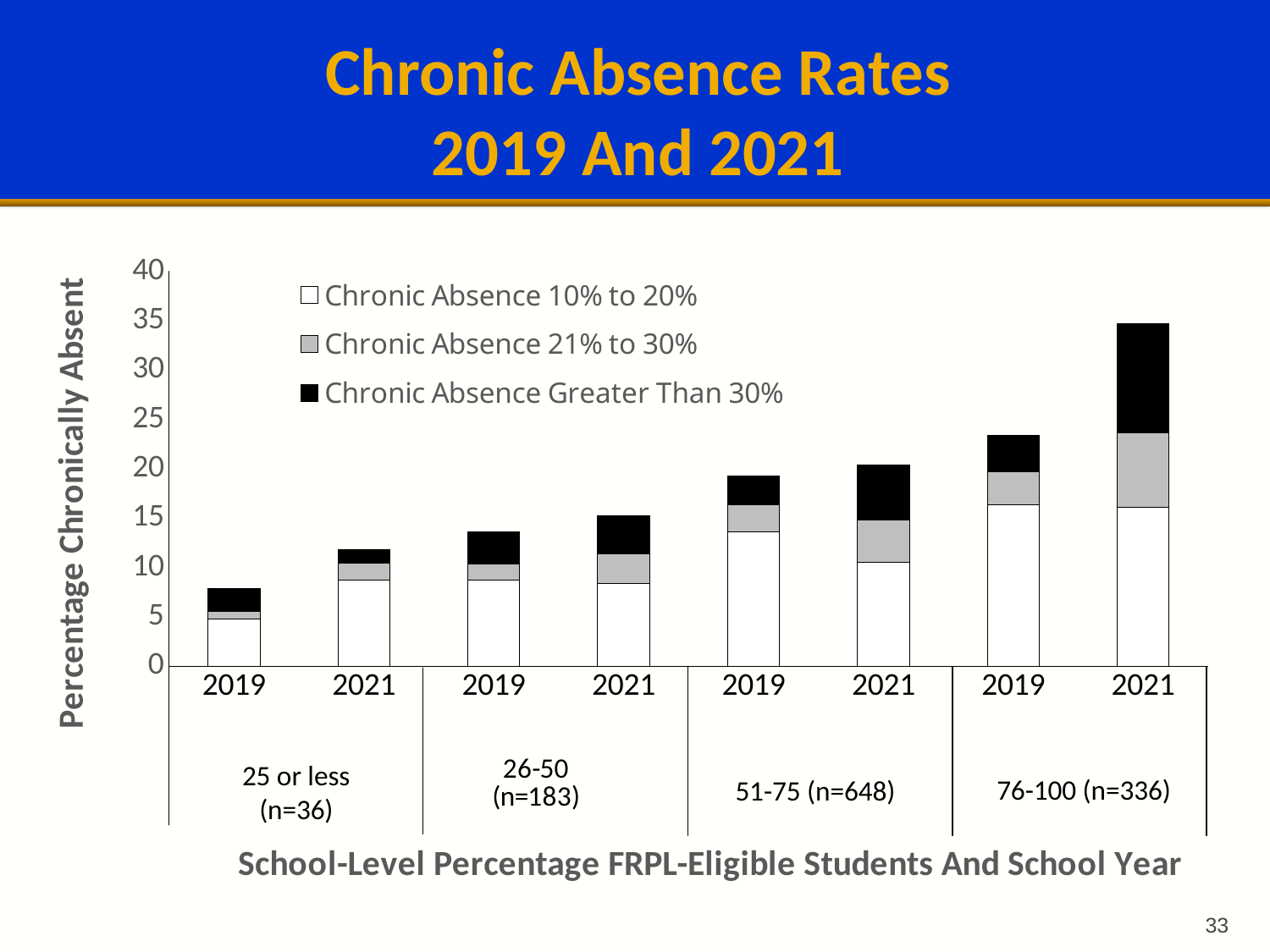
Is the total percentage chronically absent for the 25 or less group in 2019 greater or less than 10? less What kind of chart is shown on the slide? Stacked bar chart Moving from the 25 or less group to the 76-100 group, do the 2021 total percentages chronically absent rise or fall? Rise Is the total percentage chronically absent for the 76-100 group in 2019 greater or less than 20? greater Which bar has the lowest total percentage chronically absent? 25 or less (n=36), 2019 Which bar has the highest total percentage chronically absent? 76-100 (n=336), 2021 How many bars are plotted in the chart? 8 Within the 76-100 group, which year has the larger total percentage chronically absent, 2019 or 2021? 2021 How many series does the legend list? 3 Is the total percentage chronically absent for the 76-100 group in 2021 greater or less than 30? greater Which legend entry is shown with a black fill? Chronic Absence Greater Than 30% How many school-level FRPL-eligible percentage groups are shown on the x axis? 4